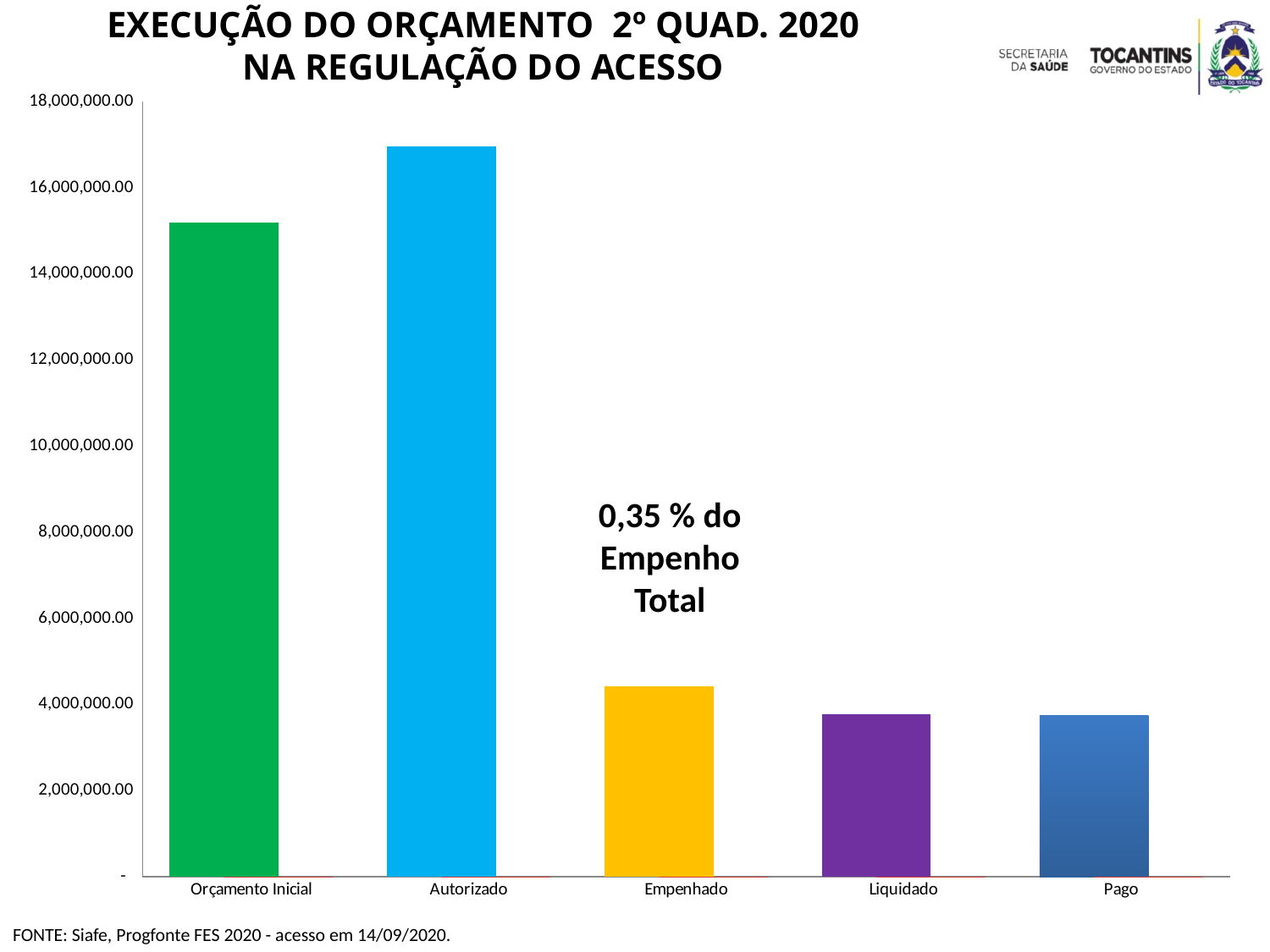
What percentage is stated in the text annotation above the Empenhado bar? 0,35 % How many categories are shown on the x axis of the chart? 5 Is the value for Orçamento Inicial greater or less than 14,000,000.00? greater Which category has the highest value in the chart? Autorizado Is the value for Orçamento Inicial greater or less than 16,000,000.00? less Is the value for Autorizado greater or less than 16,000,000.00? greater Which is larger, the value for Autorizado or the value for Orçamento Inicial? Autorizado Which is larger, the value for Empenhado or the value for Pago? Empenhado What kind of chart is shown on the slide? bar chart